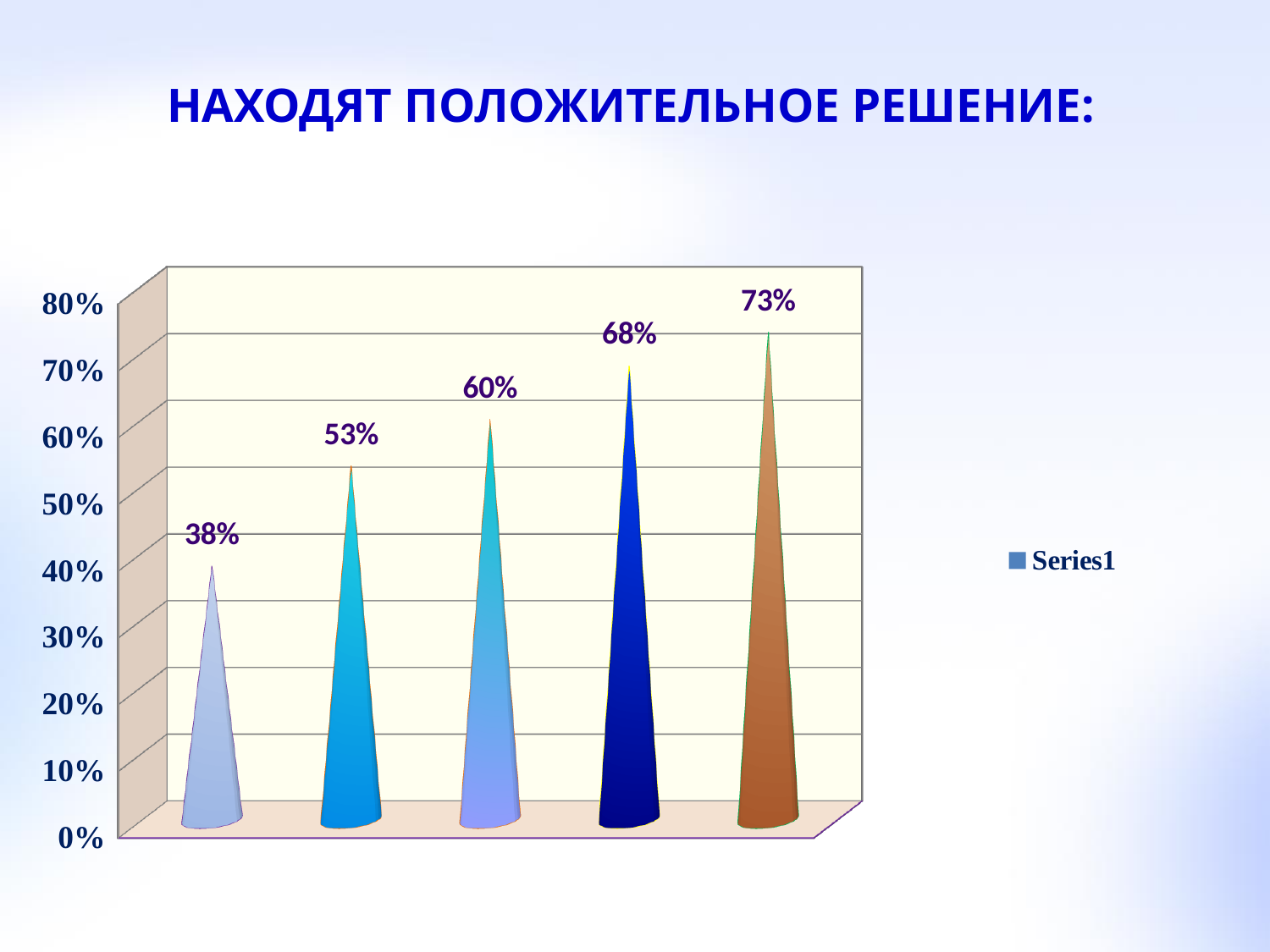
What kind of chart is shown on the slide? Bar chart What is the difference between the rightmost bar and the leftmost bar? 35% How many bars are plotted in the chart? 5 What value is shown on the leftmost bar of the chart? 38% How many series does the legend list? 1 Which bar has the highest value? The rightmost (brown) bar, 73% What value is shown on the middle (third) bar? 60% What value is shown on the dark blue bar (fourth from the left)? 68% Which bar has the lowest value? The leftmost bar, 38% What value is shown on the second bar from the left? 53% What value is shown on the rightmost (brown) bar? 73% Which is larger, the value of the second bar from the left or the value of the third bar? The third bar (60%)